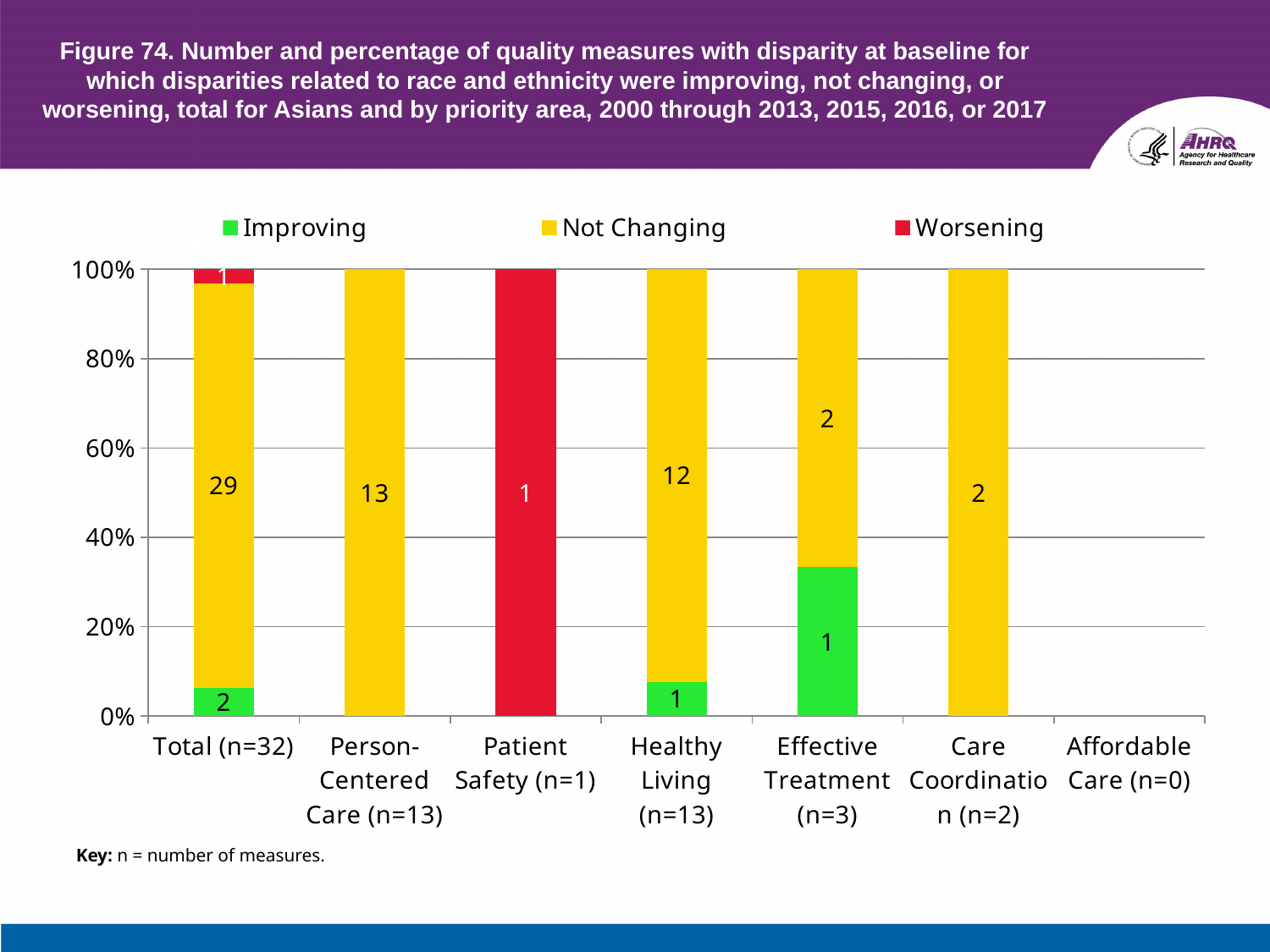
How many categories are shown on the x axis? 7 What is the difference between the Not Changing count for Total (n=32) and the Not Changing count for Healthy Living (n=13)? 17 How many measures are labeled as Not Changing for Total (n=32)? 29 How many measures are labeled as Not Changing for Effective Treatment (n=3)? 2 How many series does the legend list? 3 What kind of chart is shown on the slide? Stacked bar chart How many measures are labeled as Not Changing for Person-Centered Care (n=13)? 13 How many measures are labeled as Improving for Healthy Living (n=13)? 1 Is the Improving share of the Total (n=32) bar greater or less than 20%? less How many measures are labeled as Worsening for Patient Safety (n=1)? 1 Which has more Improving measures, Total (n=32) or Effective Treatment (n=3)? Total (n=32) Is the Not Changing share of the Effective Treatment (n=3) bar greater or less than 60%? greater